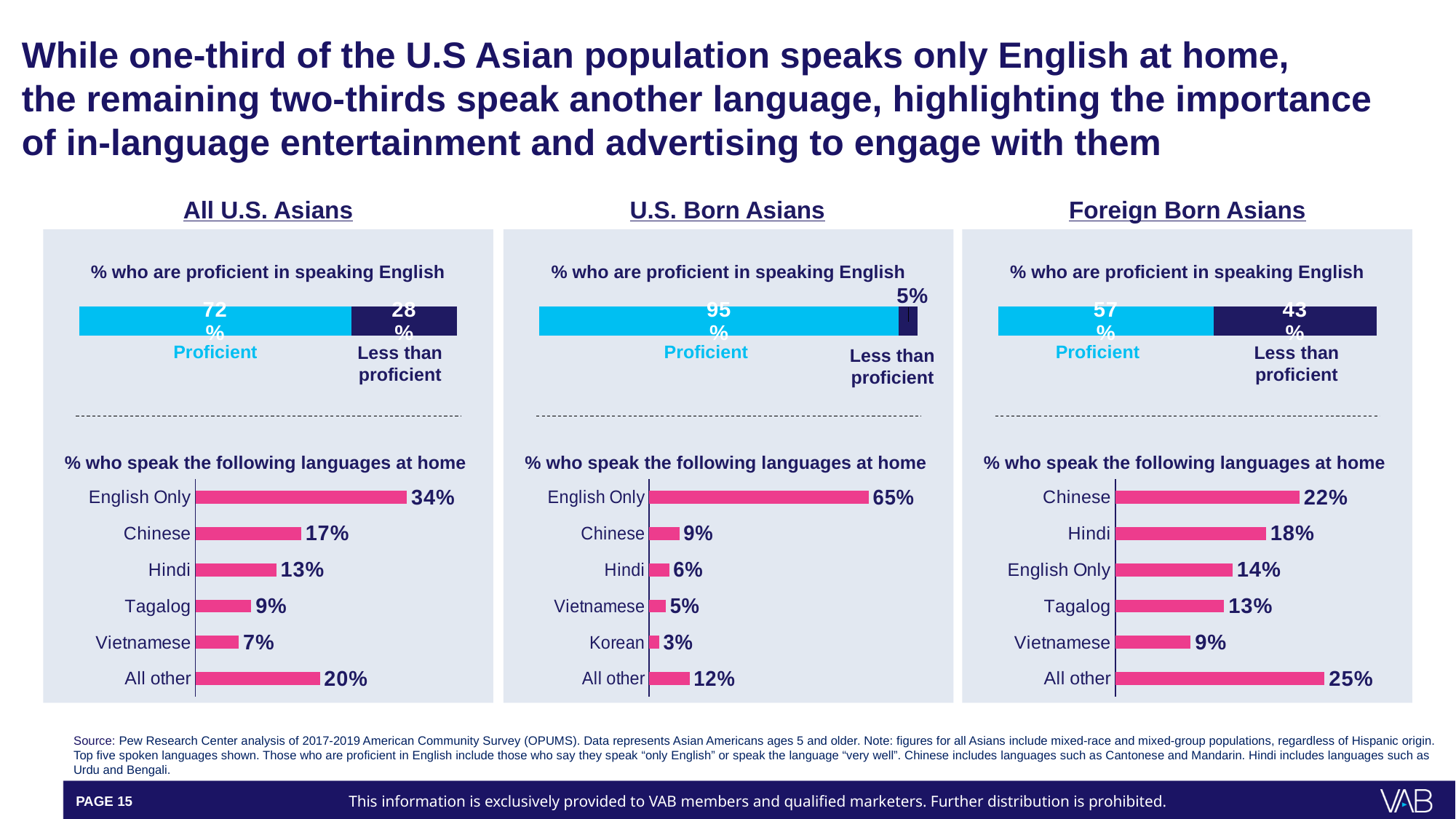
In the U.S. Born Asians panel, what is the difference between the English Only value and the Chinese value? 56% In the All U.S. Asians languages-at-home chart, what is the difference between the Chinese and Hindi values? 4% In the Foreign Born Asians languages-at-home chart, which is larger: Tagalog or Vietnamese? Tagalog In the Foreign Born Asians panel, what percentage speak Hindi at home? 18% How many language categories are shown in the U.S. Born Asians languages-at-home chart? 6 What type of chart is used to show the languages spoken at home in each panel? Bar chart In the U.S. Born Asians panel, what percentage are proficient in speaking English? 95% In the All U.S. Asians panel, what percentage are less than proficient in speaking English? 28% In the All U.S. Asians panel, what percentage speak English Only at home? 34% In the Foreign Born Asians panel, which is larger: the share who are proficient in English or the share who are less than proficient? Proficient In the U.S. Born Asians languages-at-home chart, which language has the lowest value? Korean In the Foreign Born Asians languages-at-home chart, which language category has the highest value? All other